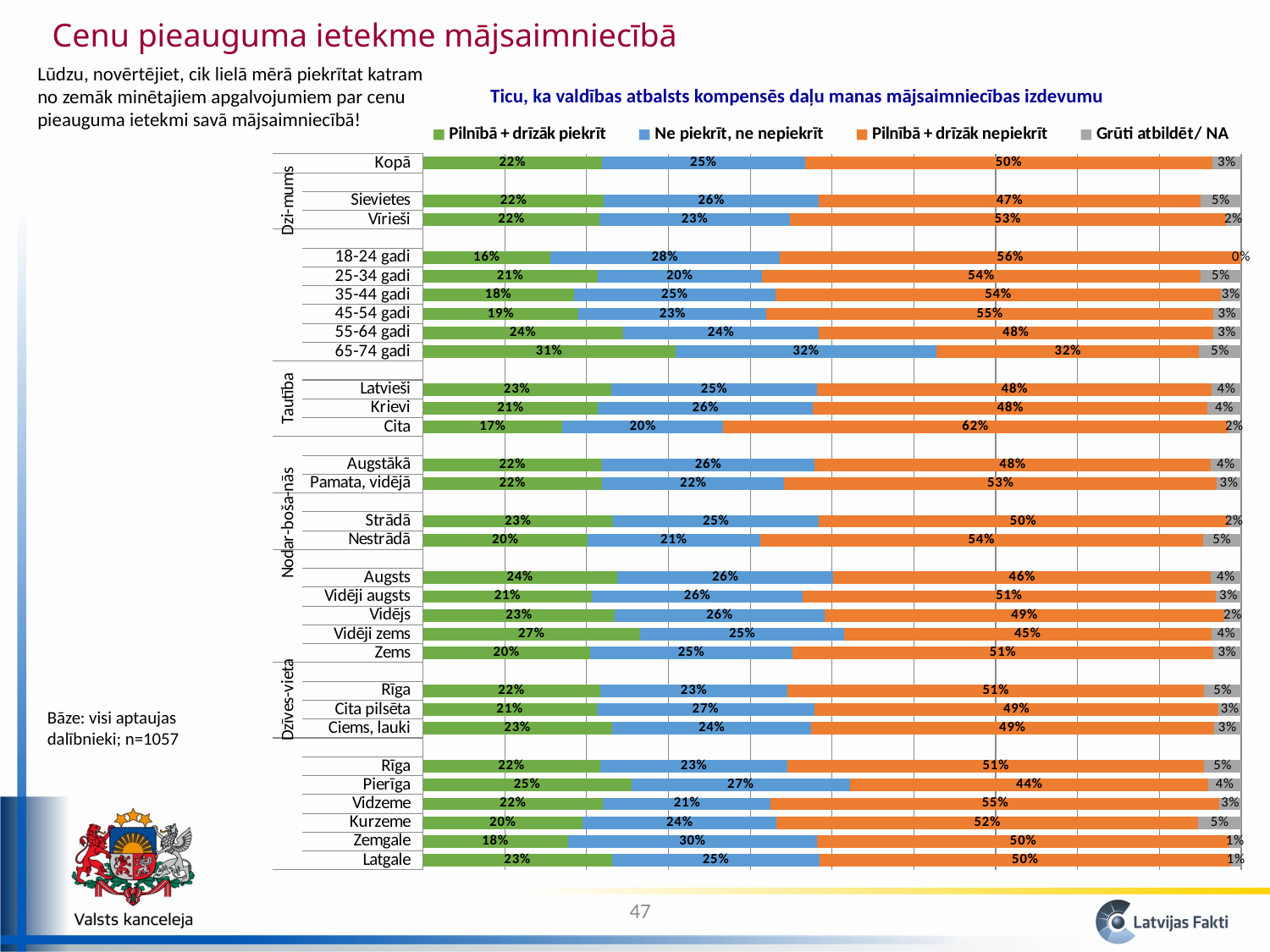
Which category has the lowest value for 'Pilnībā + drīzāk piekrīt'? 18-24 gadi What type of chart is shown on the slide? Stacked bar chart What is the 'Pilnībā + drīzāk nepiekrīt' value for 'Nestrādā'? 54% What is the 'Grūti atbildēt/ NA' value for '18-24 gadi'? 0% Which category has the highest value for 'Pilnībā + drīzāk nepiekrīt'? Cita What is the value of 'Ne piekrīt, ne nepiekrīt' for 'Zemgale'? 30% What is the value of 'Pilnībā + drīzāk piekrīt' for '65-74 gadi'? 31% What is the value of 'Pilnībā + drīzāk nepiekrīt' for the 'Kopā' row? 50% What is the difference between the 'Pilnībā + drīzāk nepiekrīt' values for 'Vīrieši' and 'Sievietes'? 6% How many series does the chart legend list? 4 What is the title of the chart? Ticu, ka valdības atbalsts kompensēs daļu manas mājsaimniecības izdevumu Which has a larger 'Pilnībā + drīzāk piekrīt' value, 'Pierīga' or 'Kurzeme'? Pierīga